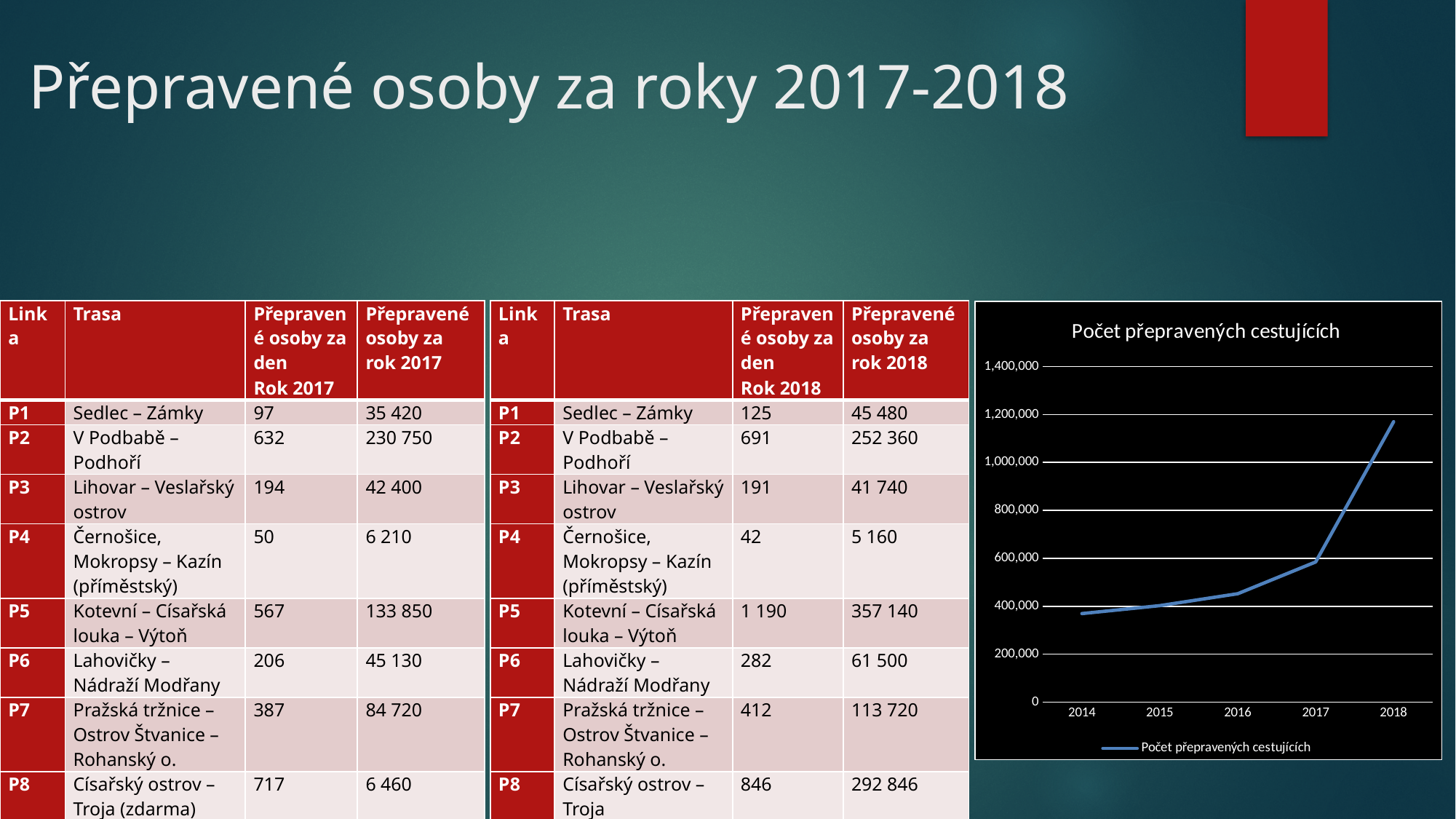
Is the value for 2018 greater or less than 1,000,000? greater Do the values in the chart rise or fall from 2014 to 2018? rise Which year has the lowest value in the chart? 2014 Is the value for 2016 greater or less than 600,000? less Is the value for 2017 greater or less than 800,000? less How many series does the chart's legend list? 1 Which year has the highest value in the chart? 2018 How many years are plotted along the x axis of the chart? 5 What is the name of the series shown in the chart's legend? Počet přepravených cestujících What is the title of the chart on the slide? Počet přepravených cestujících What kind of chart is shown on the slide? line chart Which year has the larger value, 2017 or 2018? 2018